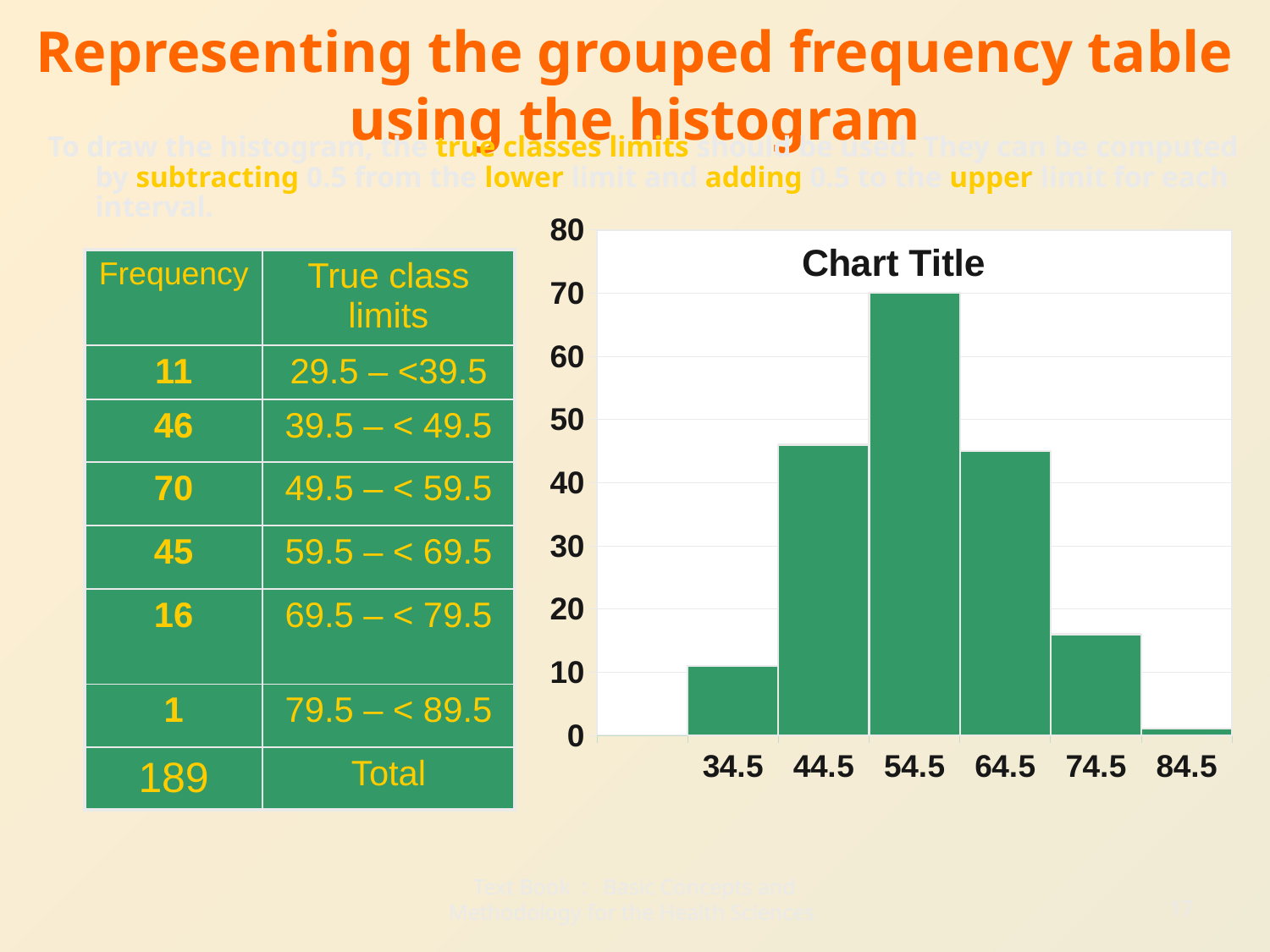
Which x-axis category has the tallest bar? 54.5 Which bar is taller, 44.5 or 74.5? 44.5 Do the bar heights rise or fall from 54.5 to 84.5 along the x axis? fall How many bars are plotted in the chart? 6 Which x-axis category has the shortest bar? 84.5 What is the value of the bar at 54.5? 70 Is the value for 74.5 greater or less than 20? less What title is displayed on the chart? Chart Title Is the value for 44.5 greater or less than 40? greater Is the value for 34.5 greater or less than 20? less What kind of chart is shown on the slide? bar chart